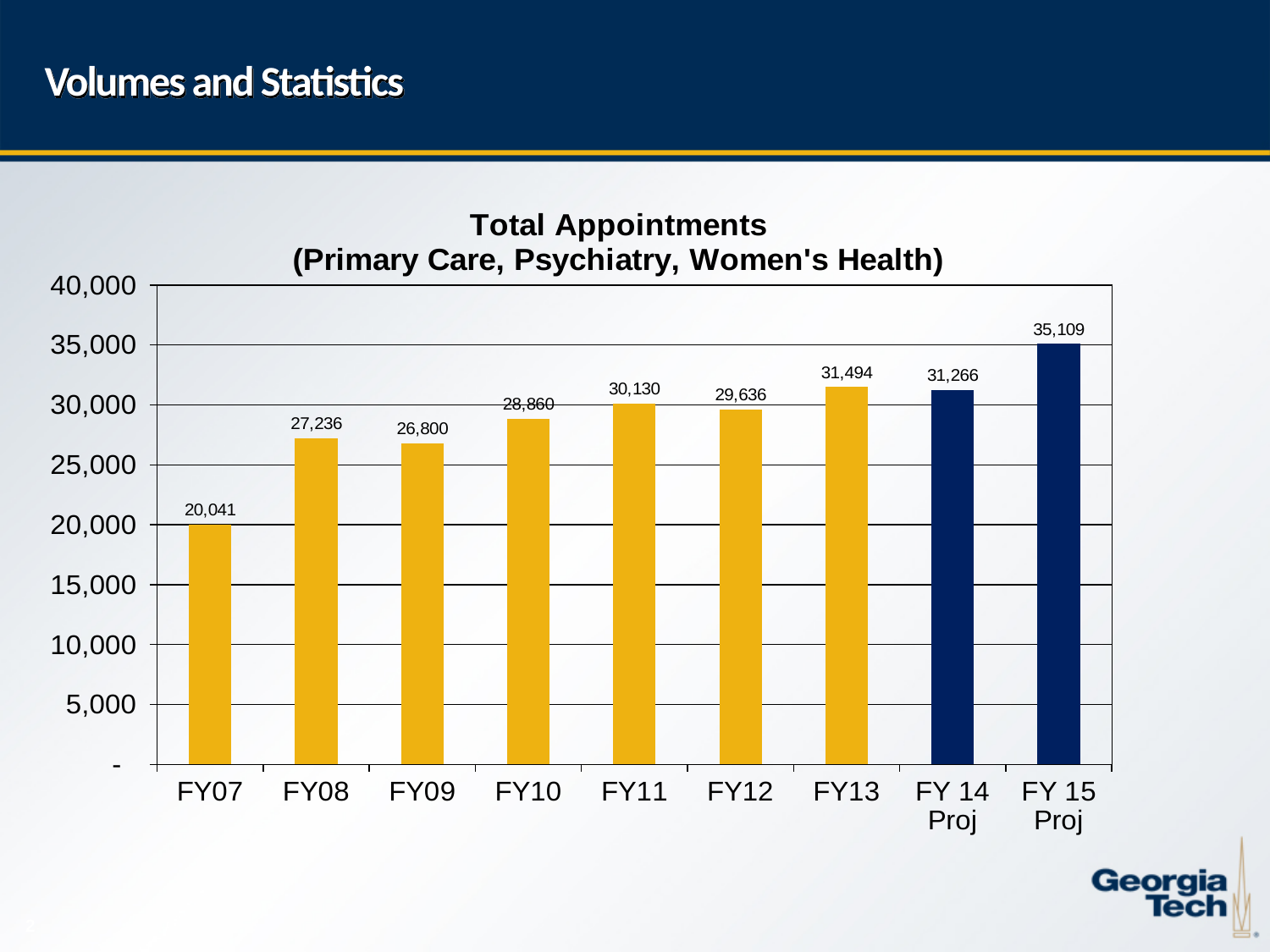
What is the value for FY07? 20,041 Which category has the lowest value? FY07 Which category has the highest value? FY 15 Proj Which is larger, the value for FY11 or the value for FY12? FY11 What is the value for FY13? 31,494 What is the title of the chart? Total Appointments (Primary Care, Psychiatry, Women's Health) What kind of chart is shown? bar chart What is the difference between the values for FY08 and FY07? 7,195 How many categories are shown on the x axis? 9 What is the value for FY 15 Proj? 35,109 Is the value for FY09 greater or less than 25,000? greater What is the difference between the values for FY 15 Proj and FY 14 Proj? 3,843